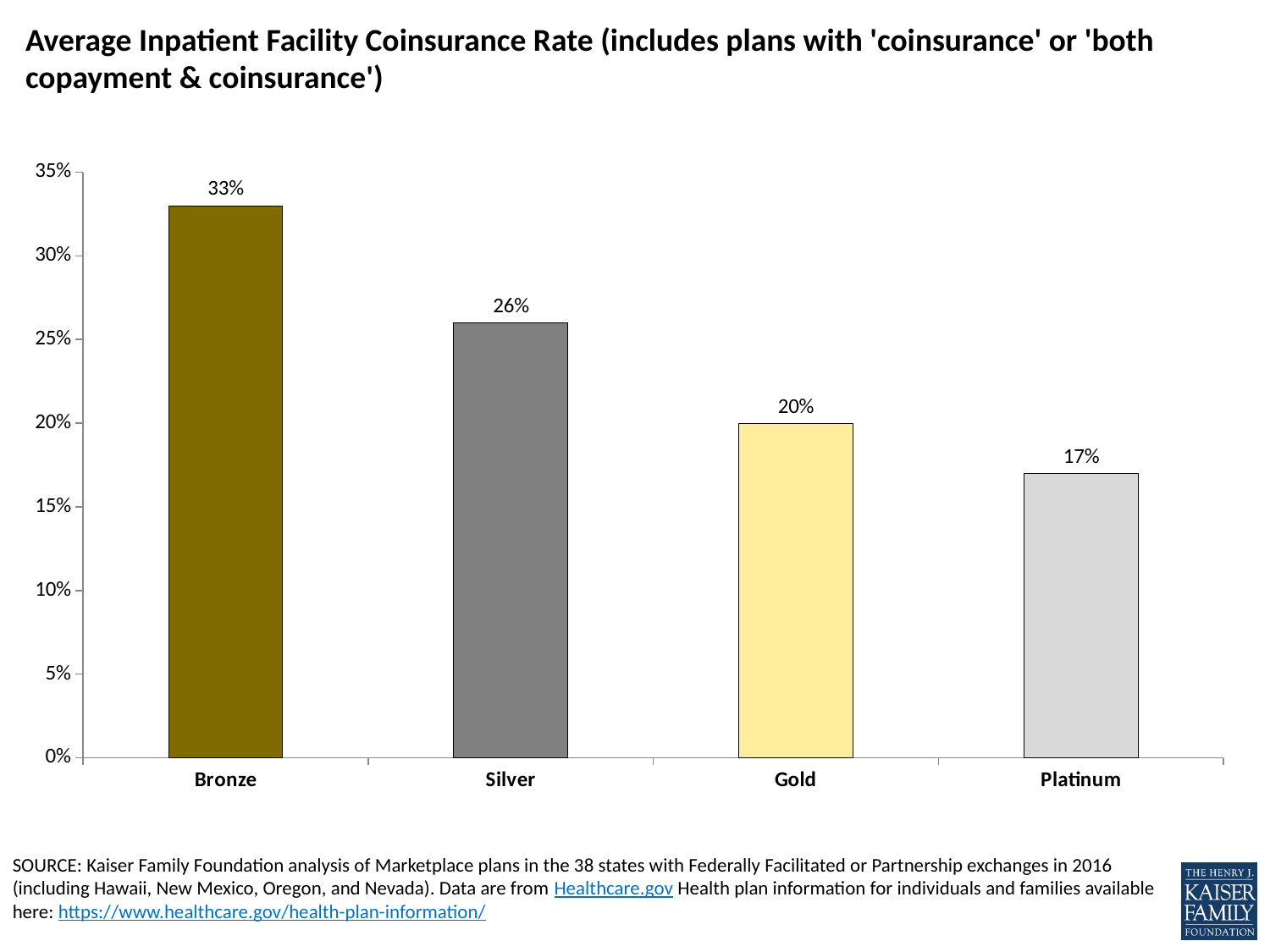
Do the coinsurance rates rise or fall moving from Bronze to Platinum along the x axis? Fall What is the difference between the Silver and Gold average coinsurance rates? 6% What is the average inpatient facility coinsurance rate for Gold plans? 20% How many plan tiers are shown on the chart? 4 Which plan tier has the highest average inpatient facility coinsurance rate? Bronze Which plan tier has the lowest average inpatient facility coinsurance rate? Platinum What is the average inpatient facility coinsurance rate for Silver plans? 26% Which has a higher average coinsurance rate, Silver or Gold? Silver What is the average inpatient facility coinsurance rate for Platinum plans? 17% What is the average inpatient facility coinsurance rate for Bronze plans? 33% What kind of chart is shown on the slide? Bar chart What is the difference between the Bronze and Platinum average coinsurance rates? 16%